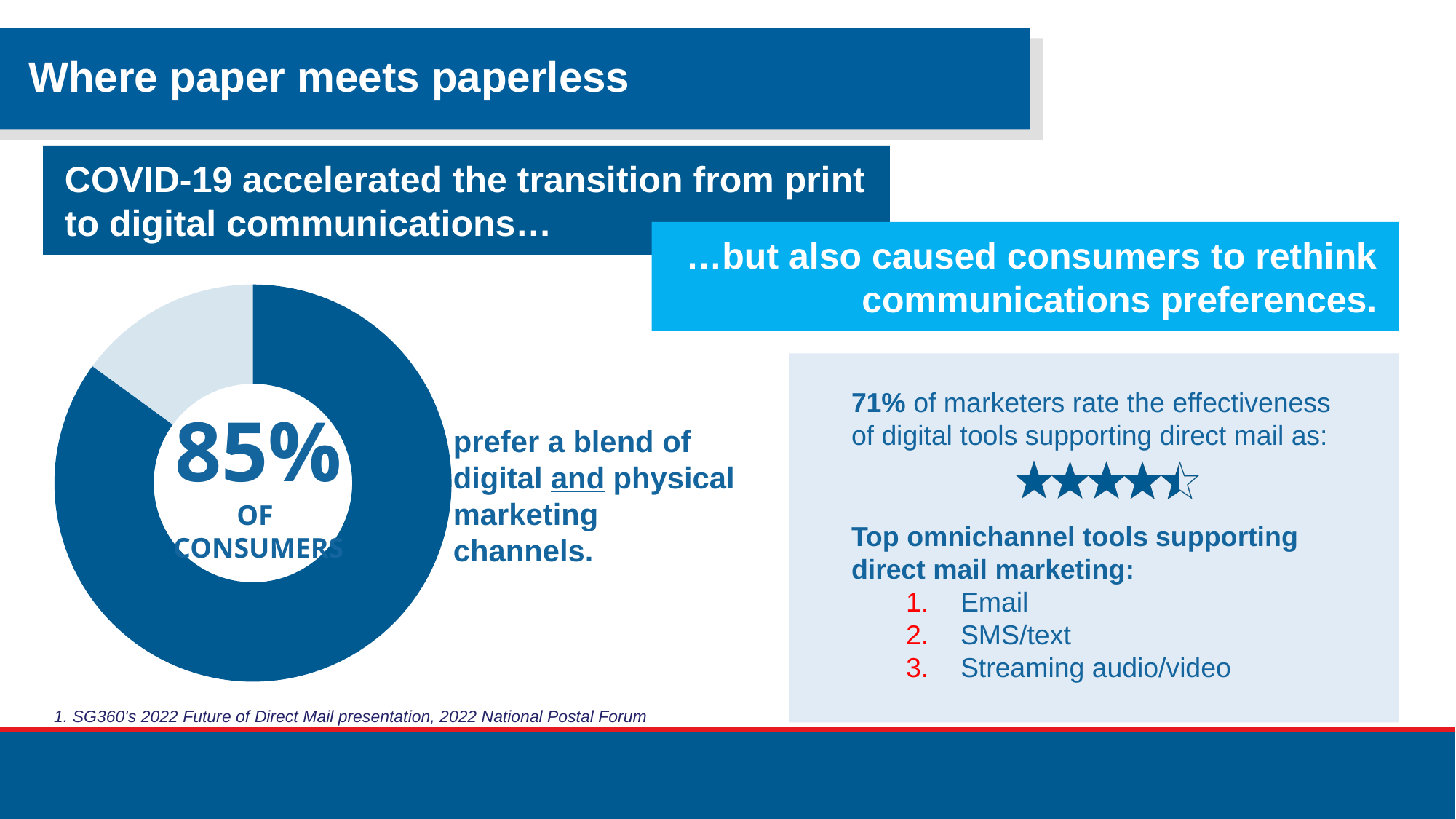
What percentage is printed in the centre of the donut chart? 85% What do the 85% of consumers in the donut chart prefer? A blend of digital and physical marketing channels Which slice of the donut chart is larger, the dark blue one or the light grey one? Dark blue How many slices does the donut chart have? 2 What kind of chart is shown on the left of the slide? Donut (pie) chart According to the donut chart, what group does the 85% figure refer to? Consumers What share of the donut chart does the dark blue slice represent? 85% Which slice of the donut chart is the smallest? The light grey slice